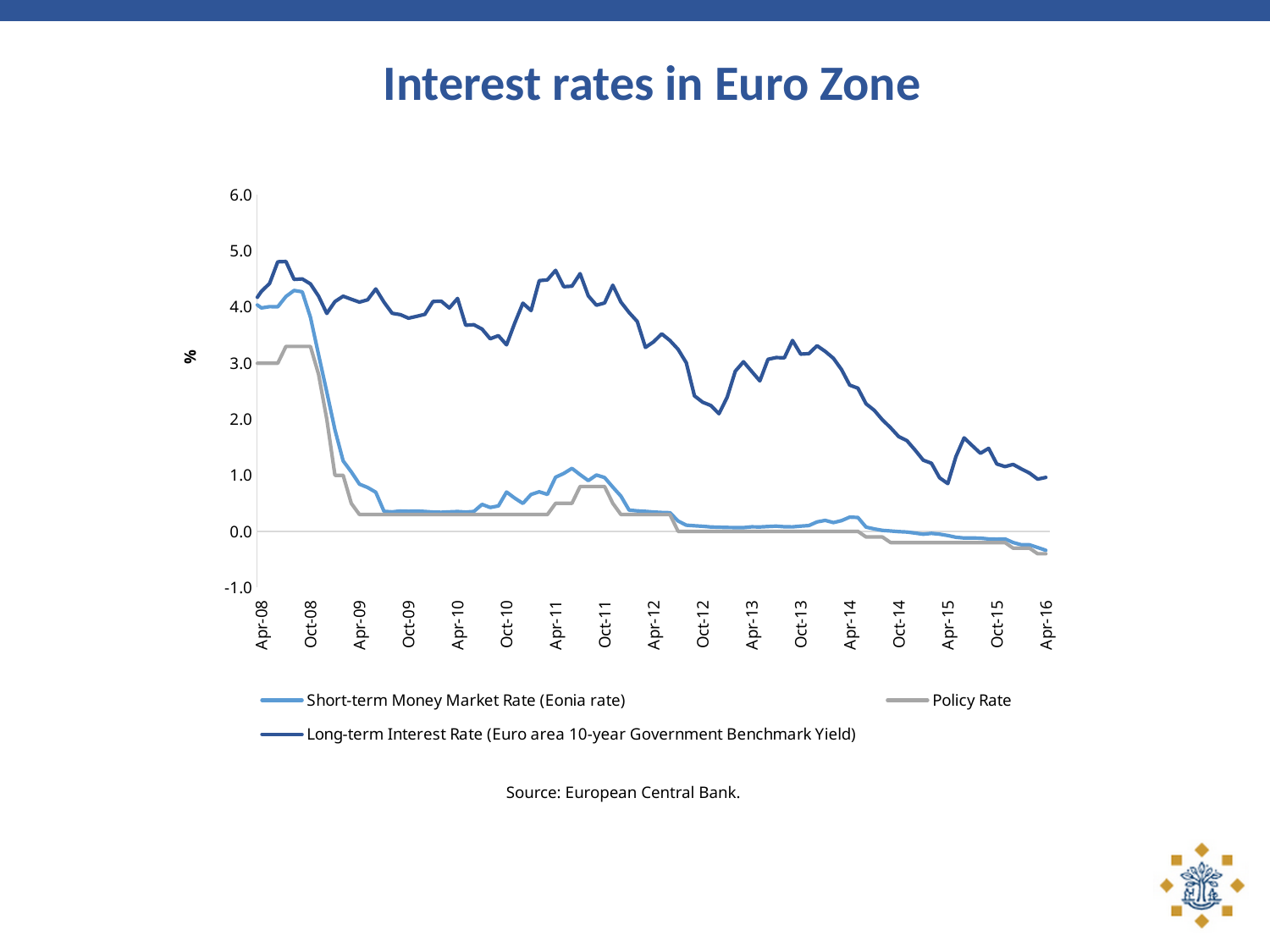
Is the Short-term Money Market Rate (Eonia rate) at Oct-09 greater or less than 1.0? less Does the Long-term Interest Rate rise or fall between Oct-13 and Apr-16? Fall Is the Policy Rate at Oct-08 greater or less than 3.0? greater What kind of chart is shown on the slide? Line chart How many series does the legend list? 3 What is the title of the chart? Interest rates in Euro Zone Is the Long-term Interest Rate at Apr-16 greater or less than 2.0? less Which series has the highest value at Apr-14? Long-term Interest Rate What source is cited below the chart? European Central Bank At Apr-12, which is larger: the Long-term Interest Rate or the Short-term Money Market Rate (Eonia rate)? Long-term Interest Rate At Oct-08, which is larger: the Short-term Money Market Rate (Eonia rate) or the Policy Rate? Short-term Money Market Rate (Eonia rate)